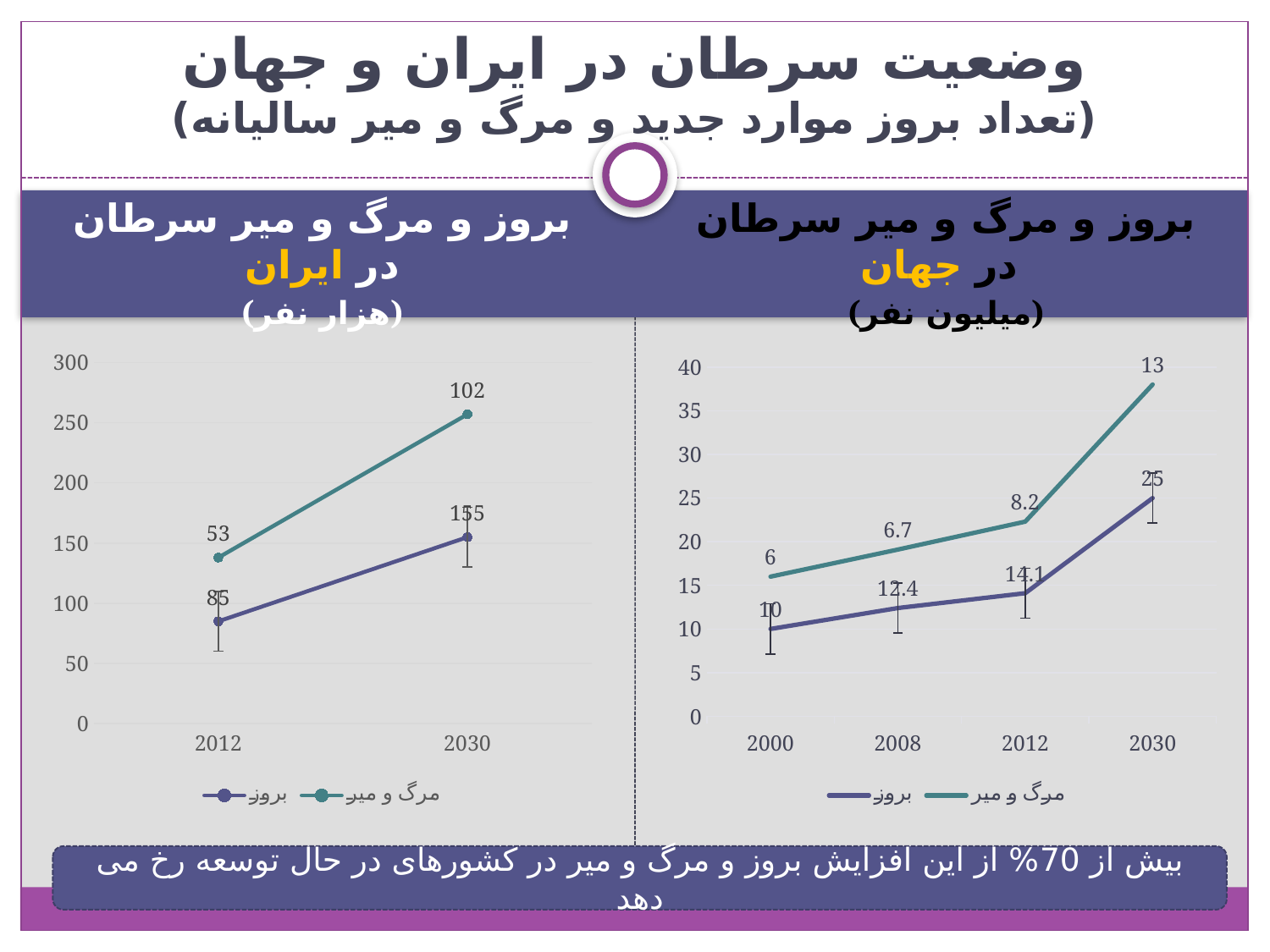
In the left chart (cancer in Iran), what is the value of بروز (incidence) in 2030? 155 In the right chart (cancer in the world), what is the difference between the مرگ و میر values for 2012 and 2000? 2.2 How many series does the legend of the left chart (cancer in Iran) list? 2 In the right chart (cancer in the world), which year has the highest مرگ و میر value? 2030 According to its title, in what unit are the values of the left chart (cancer in Iran) given? هزار نفر (thousand people) In the right chart (cancer in the world), how many years are shown on the x axis? 4 In the left chart (cancer in Iran), by how much does the labelled بروز value increase from 2012 to 2030? 70 In the right chart (cancer in the world), does the بروز series rise or fall from 2000 to 2030? Rises In the right chart (cancer in the world), what is the value of بروز (incidence) in 2008? 12.4 In the right chart (cancer in the world), what is the value of مرگ و میر (mortality) in 2030? 13 In the left chart (cancer in Iran), what is the value of مرگ و میر (mortality) in 2012? 53 What kind of chart is the right chart (cancer in the world)? Line chart